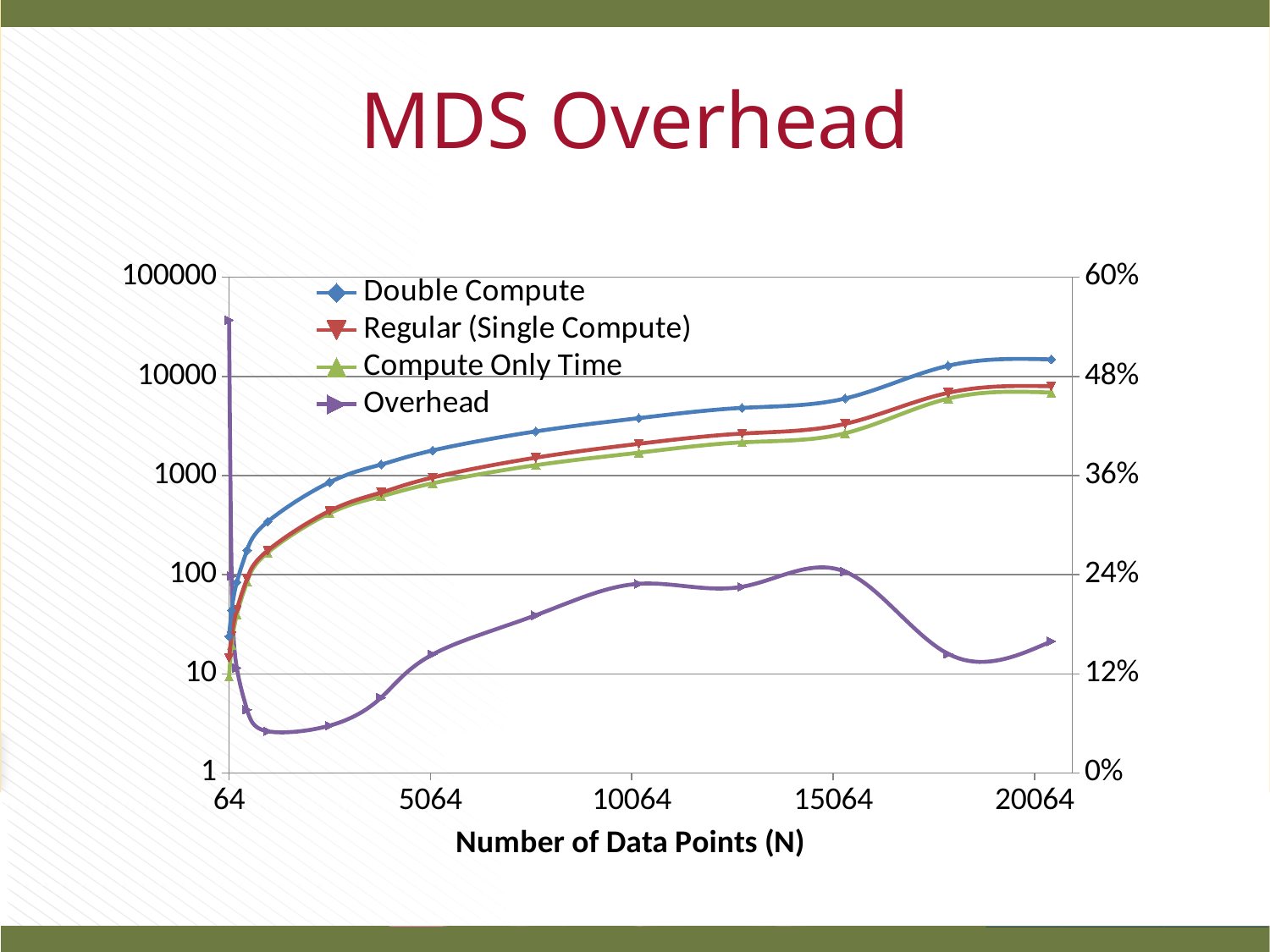
Which series has the highest values across the range of N on the left axis? Double Compute What is the title of the chart? MDS Overhead Is the value for Double Compute at N = 20064 greater or less than 10000? greater At N = 10064, which is larger: Regular (Single Compute) or Compute Only Time? Regular (Single Compute) Is the value for Compute Only Time at N = 20064 greater or less than 10000? less Is the value for Overhead at N = 64 greater or less than 48%? greater What kind of chart is shown on the slide? line chart How many series does the legend list? 4 Does the Double Compute series rise or fall as the number of data points increases? rise What is the x-axis title of the chart? Number of Data Points (N) At N = 20064, which is larger: Double Compute or Compute Only Time? Double Compute